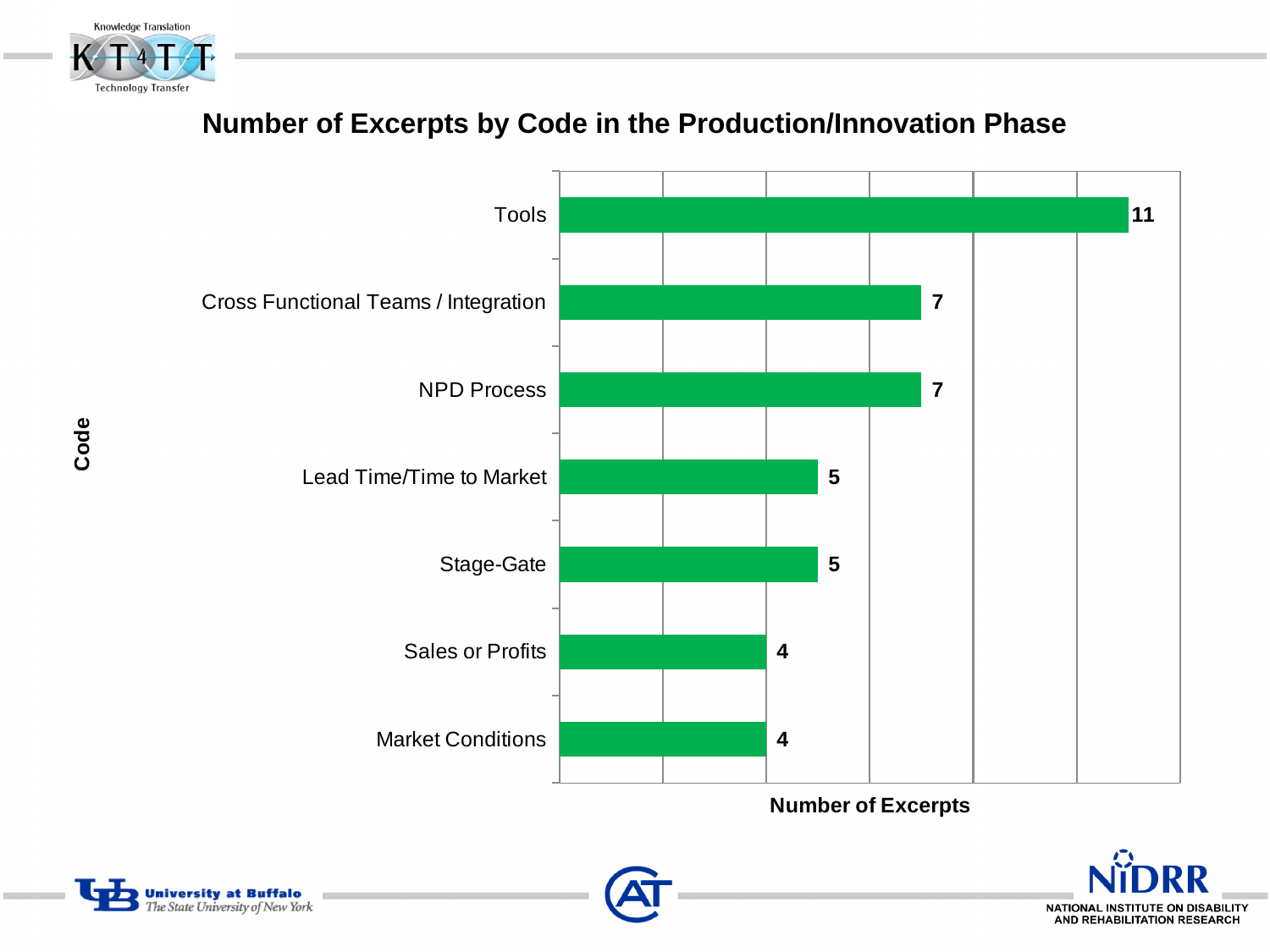
What is the difference in number of excerpts between Stage-Gate and Market Conditions? 1 Which has more excerpts, Cross Functional Teams / Integration or Stage-Gate? Cross Functional Teams / Integration What is the number of excerpts for Lead Time/Time to Market? 5 What is the number of excerpts for Tools? 11 What is the title of the chart? Number of Excerpts by Code in the Production/Innovation Phase What is the difference in number of excerpts between Tools and NPD Process? 4 What is the number of excerpts for Cross Functional Teams / Integration? 7 What kind of chart is shown on the slide? Bar chart What is the number of excerpts for Sales or Profits? 4 Which code has the highest number of excerpts? Tools What is the label of the horizontal axis? Number of Excerpts How many codes are shown in the chart? 7